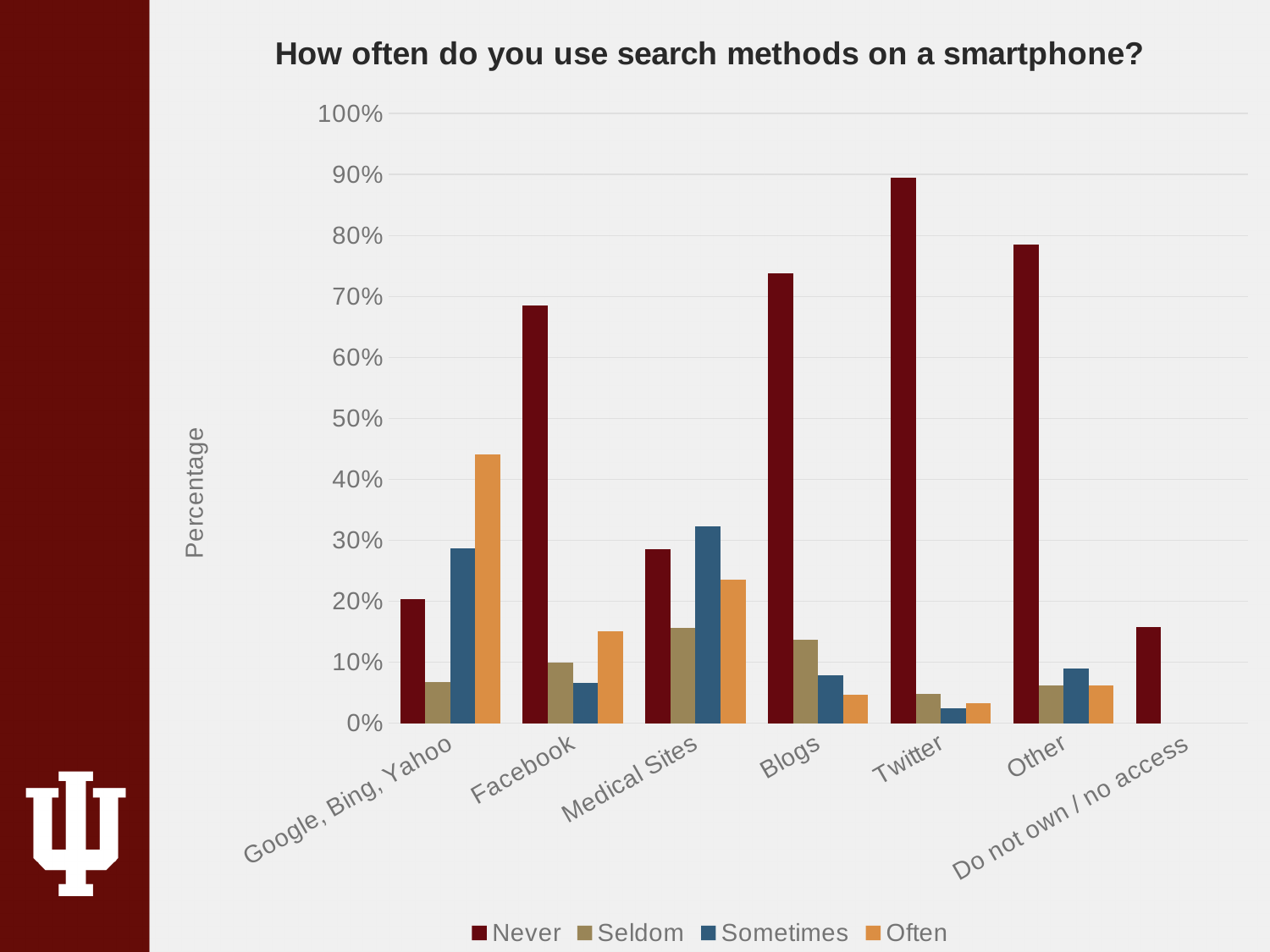
How many categories are shown on the x axis? 7 What kind of chart is shown on the slide? bar chart Is the 'Never' value for Twitter greater or less than 80%? greater Which is larger: the 'Never' value for Facebook or the 'Never' value for Blogs? Blogs Is the 'Seldom' value for Medical Sites greater or less than 20%? less What is the title of the chart? How often do you use search methods on a smartphone? Which is larger: the 'Often' value for Medical Sites or the 'Often' value for Facebook? Medical Sites Which category has the highest 'Never' bar? Twitter How many series does the legend list? 4 Which category has the highest 'Often' bar? Google, Bing, Yahoo Is the 'Often' value for Google, Bing, Yahoo greater or less than 40%? greater